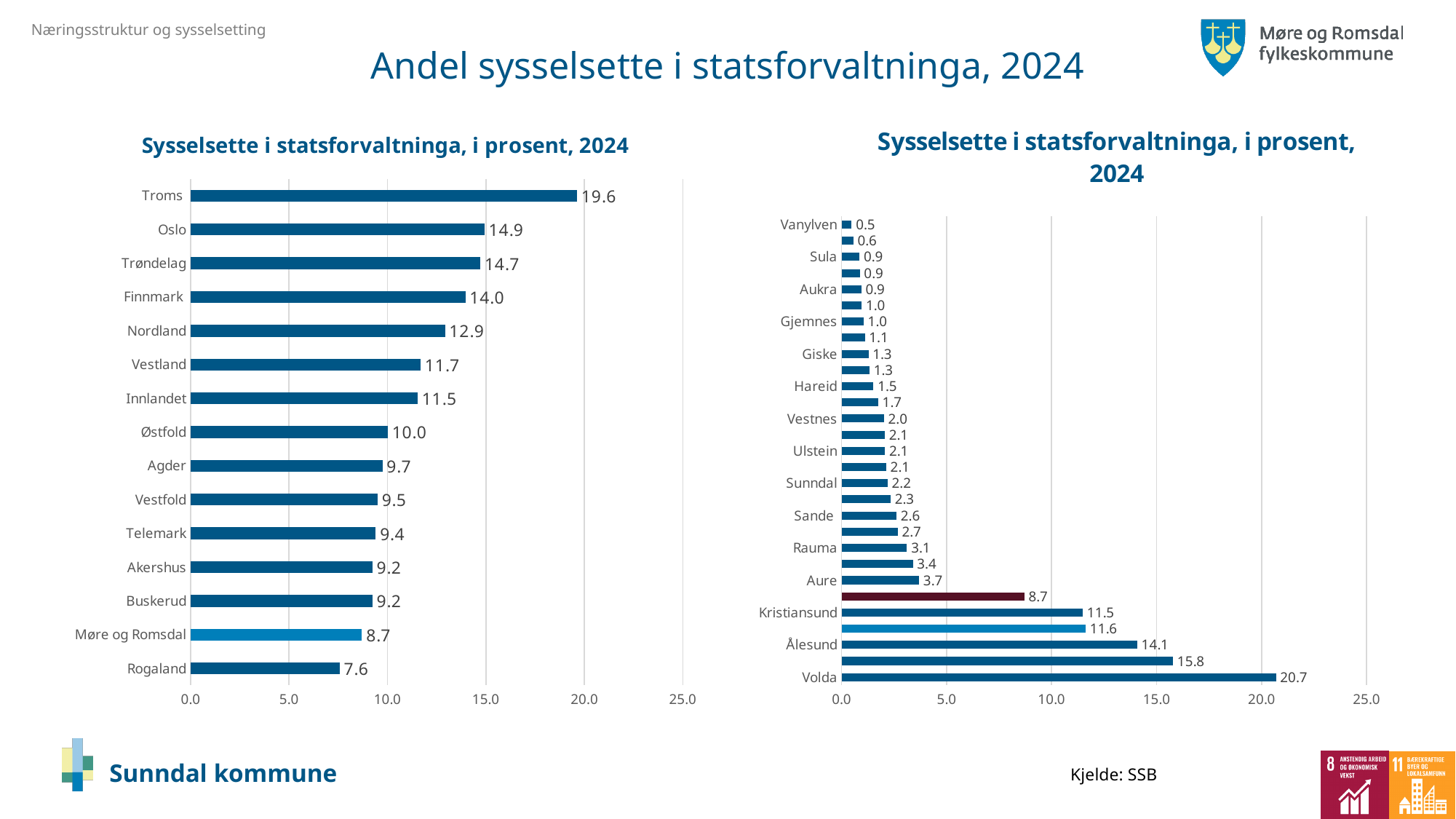
In the right chart, what is the value for Sunndal? 2.2 In the left chart, what is the value for Troms? 19.6 In the left chart, which category has the lowest value? Rogaland In the right chart, which category has the highest value? Volda What kind of chart is the left chart? Bar chart In the left chart, what is the value for Møre og Romsdal? 8.7 In the left chart, what is the difference between the values for Oslo and Trøndelag? 0.2 In the right chart, is the value for Kristiansund greater or less than 10.0? greater In the left chart, which category has the highest value? Troms How many categories are shown in the left chart? 15 In the left chart, which is larger, the value for Nordland or the value for Vestland? Nordland In the right chart, what is the value for Volda? 20.7